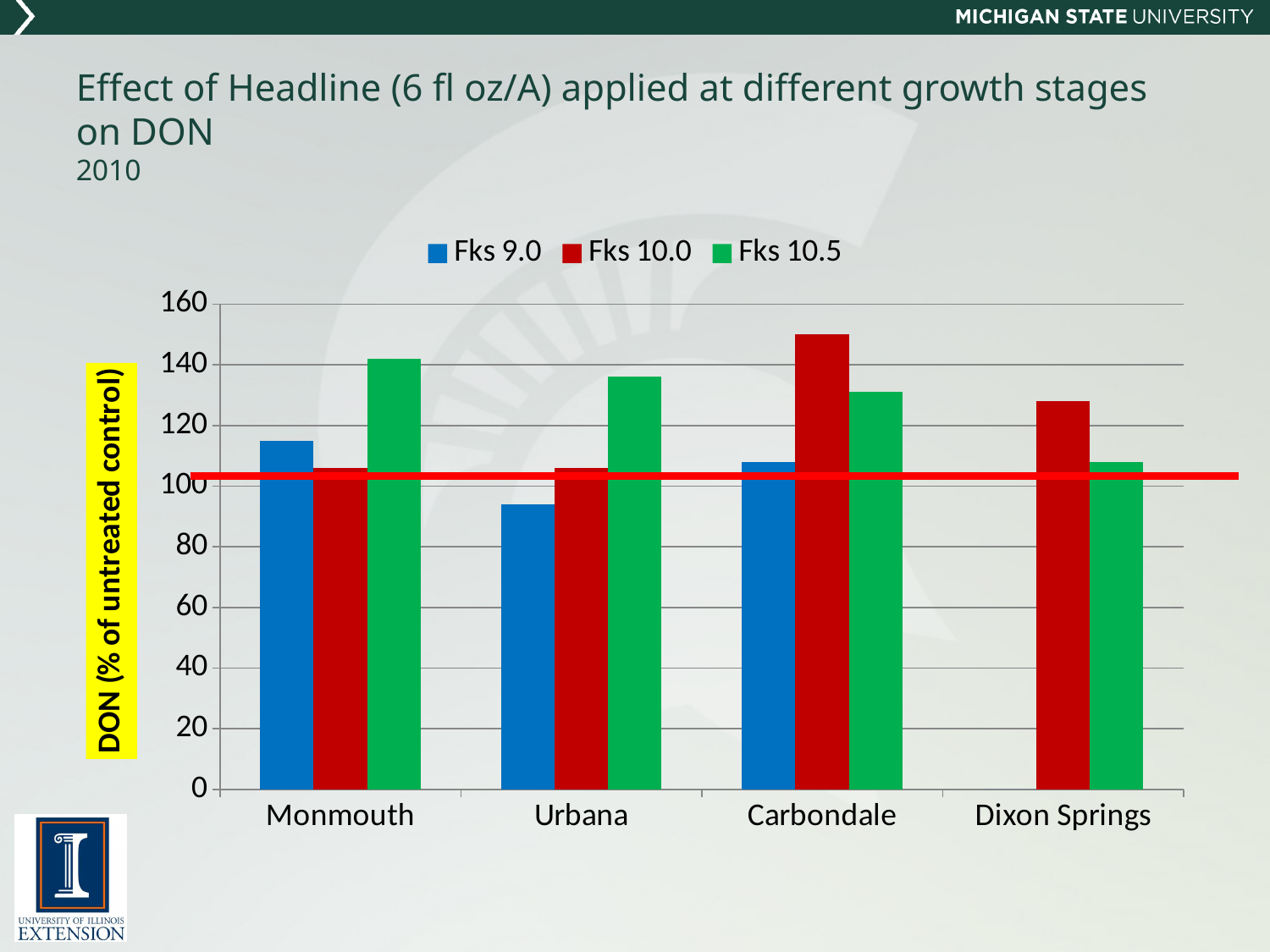
Is the Fks 10.0 value for Carbondale greater or less than 140? greater How many locations are shown along the x axis? 4 Is the Fks 10.0 value for Dixon Springs greater or less than 120? greater What kind of chart is shown on the slide? bar chart What is the label on the y axis? DON (% of untreated control) At Monmouth, which is larger: the Fks 9.0 value or the Fks 10.5 value? Fks 10.5 How many series does the legend list? 3 Which location and growth stage has the highest DON value? Carbondale, Fks 10.0 Is the Fks 9.0 value for Urbana greater or less than 100? less Which location has no Fks 9.0 bar? Dixon Springs At Carbondale, which is larger: the Fks 10.0 value or the Fks 10.5 value? Fks 10.0 Which location and growth stage has the lowest DON value? Urbana, Fks 9.0